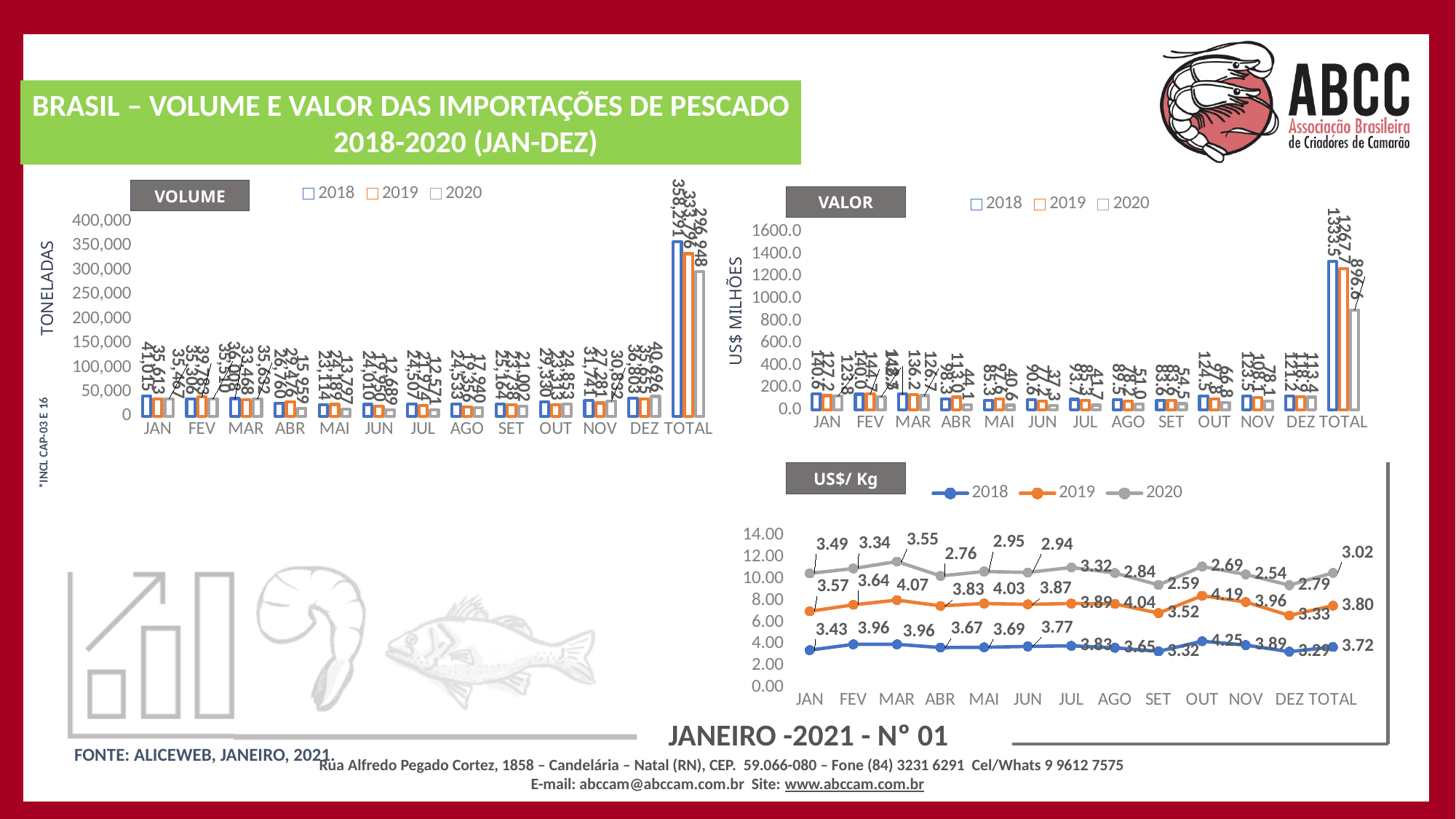
How many categories are shown on the x axis of the VALOR chart? 13 In the US$/Kg chart, what is the TOTAL value for 2020? 3.02 In the US$/Kg chart, what is the value for 2019 in MAR? 4.07 In the VALOR chart, what is the TOTAL value for 2018? 1333.5 In the VOLUME chart, what is the TOTAL value for 2020? 296,948 In the VOLUME chart, what is the TOTAL value for 2018? 358,291 In the VALOR chart, what is the TOTAL value for 2020? 896.6 What kind of chart is the US$/Kg chart? line chart In the VALOR chart, what is the difference between the 2019 TOTAL and the 2020 TOTAL? 371.1 In the VOLUME chart, what is the difference between the 2018 TOTAL and the 2020 TOTAL? 61,343 In the VOLUME chart, which TOTAL bar is larger, 2018 or 2019? 2018 How many series does the legend of the VOLUME chart list? 3